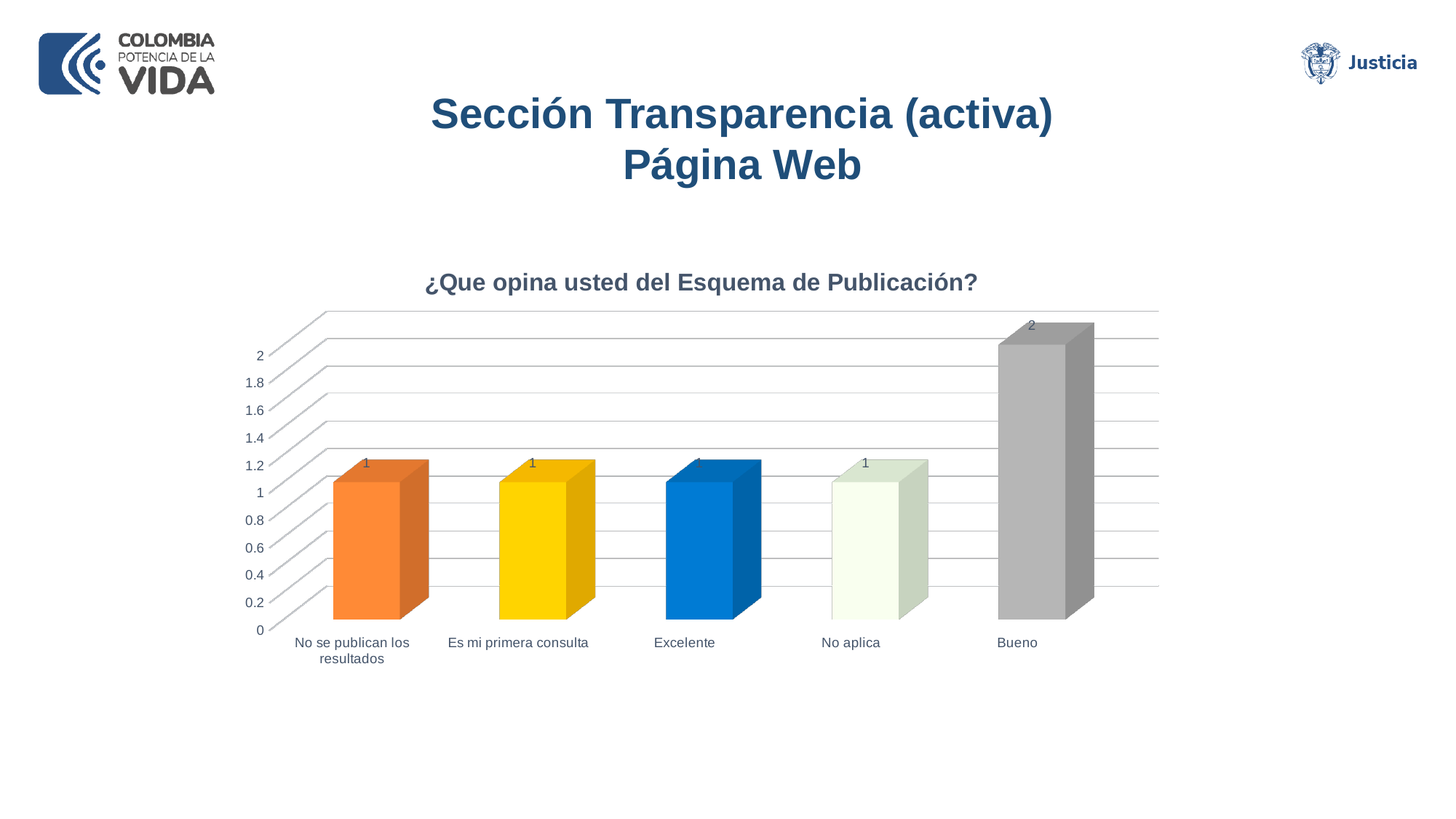
What kind of chart is shown on the slide? bar chart Which is larger, the value for Bueno or the value for No aplica? Bueno What colour is the bar for Bueno? grey What is the value for Excelente? 1 What is the total of all the values shown in the chart? 6 What is the value for Es mi primera consulta? 1 What is the value for No aplica? 1 Which category has the highest value? Bueno What is the value for Bueno? 2 How many categories are shown on the x axis? 5 What is the title of the chart? ¿Que opina usted del Esquema de Publicación? What is the difference between the values for Bueno and Excelente? 1